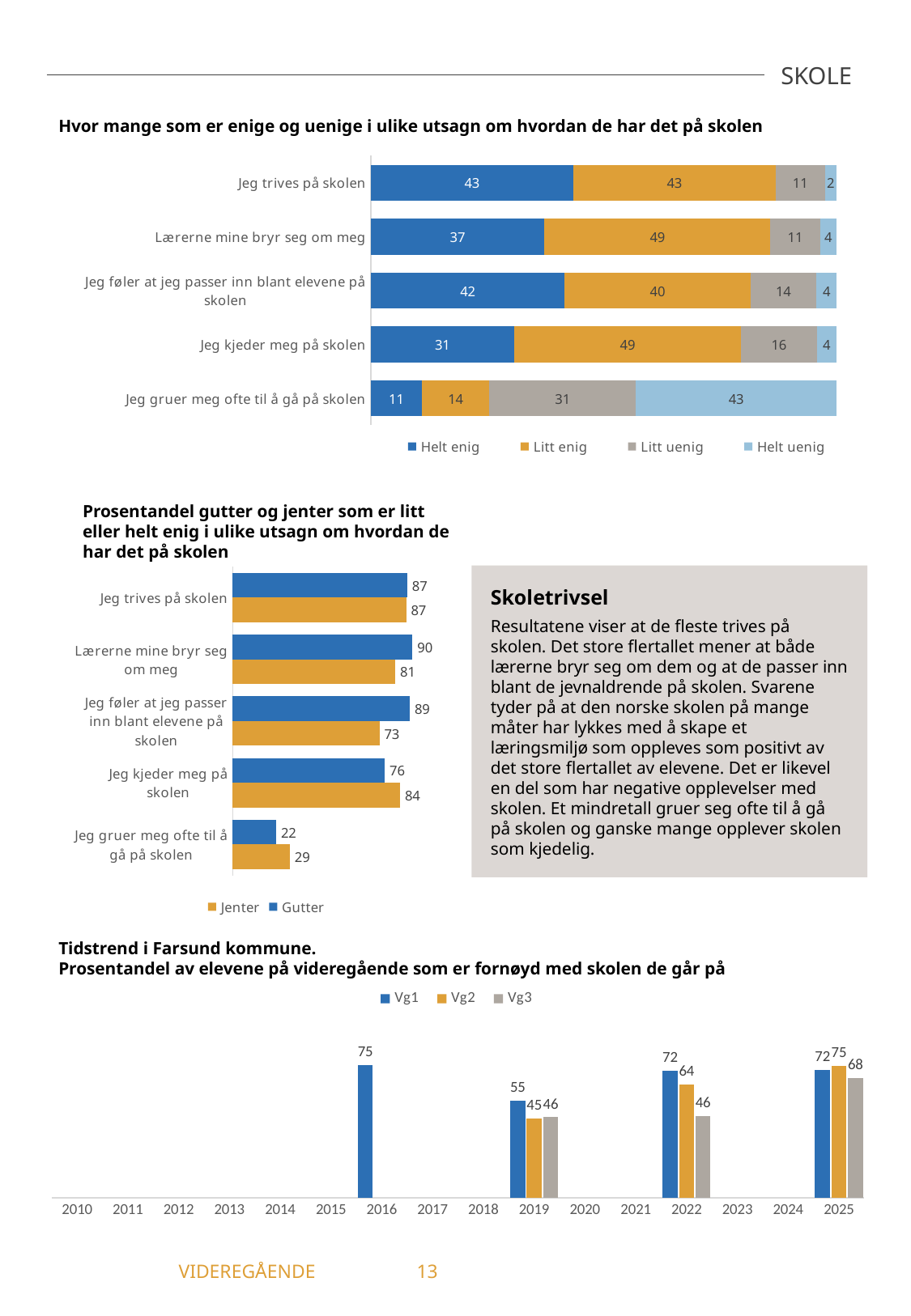
In the chart 'Prosentandel gutter og jenter som er litt eller helt enig i ulike utsagn om hvordan de har det på skolen', which is larger for 'Jeg kjeder meg på skolen', Gutter or Jenter? Jenter In the chart 'Tidstrend i Farsund kommune', what is the Vg1 value for 2016? 75 In the chart 'Hvor mange som er enige og uenige i ulike utsagn om hvordan de har det på skolen', what is the 'Helt enig' value for 'Jeg kjeder meg på skolen'? 31 In the chart 'Prosentandel gutter og jenter som er litt eller helt enig i ulike utsagn om hvordan de har det på skolen', which statement has the lowest value for Gutter? Jeg gruer meg ofte til å gå på skolen In the chart 'Prosentandel gutter og jenter som er litt eller helt enig i ulike utsagn om hvordan de har det på skolen', what is the value for Jenter on 'Jeg føler at jeg passer inn blant elevene på skolen'? 73 In the chart 'Hvor mange som er enige og uenige i ulike utsagn om hvordan de har det på skolen', what is the 'Helt uenig' value for 'Jeg gruer meg ofte til å gå på skolen'? 43 In the chart 'Hvor mange som er enige og uenige i ulike utsagn om hvordan de har det på skolen', how many series does the legend list? 4 In the chart 'Prosentandel gutter og jenter som er litt eller helt enig i ulike utsagn om hvordan de har det på skolen', what is the difference between Gutter and Jenter for 'Lærerne mine bryr seg om meg'? 9 In the chart 'Hvor mange som er enige og uenige i ulike utsagn om hvordan de har det på skolen', what is the total of the stacked bar for 'Lærerne mine bryr seg om meg'? 101 What kind of chart is 'Tidstrend i Farsund kommune'? Bar chart In the chart 'Tidstrend i Farsund kommune', what is the Vg3 value for 2025? 68 In the chart 'Tidstrend i Farsund kommune', which series has the highest value in 2025? Vg2